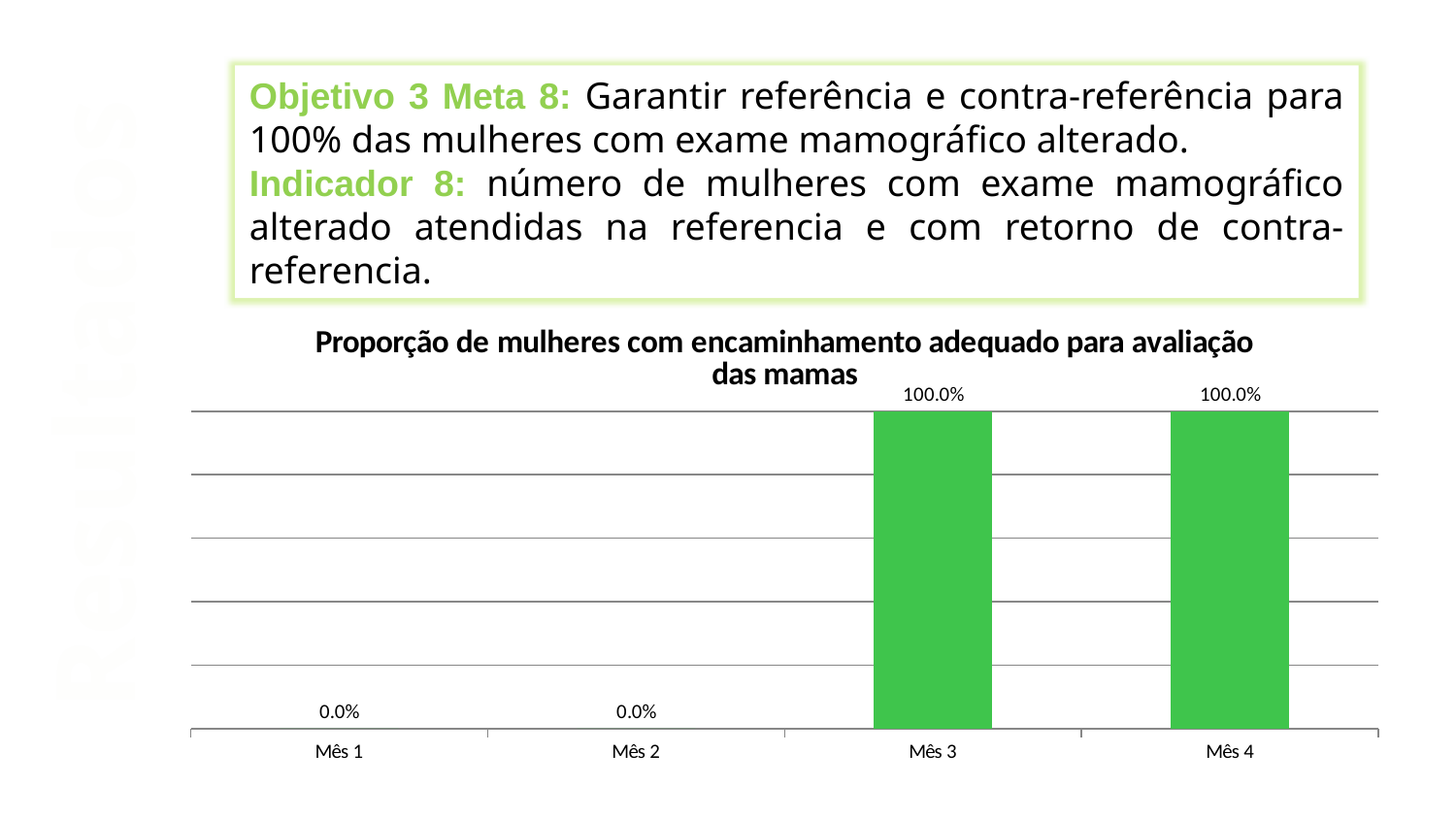
Which months share the highest value in the chart? Mês 3 and Mês 4 Which months share the lowest value in the chart? Mês 1 and Mês 2 What is the value for Mês 4? 100.0% What is the value for Mês 2? 0.0% What is the value for Mês 3? 100.0% What is the value for Mês 1? 0.0% What is the difference between the values for Mês 3 and Mês 1? 100.0% What kind of chart is shown on the slide? bar chart Which is larger, the value for Mês 2 or the value for Mês 4? Mês 4 Do the values rise or fall from Mês 1 to Mês 4? rise What is the title of the chart? Proporção de mulheres com encaminhamento adequado para avaliação das mamas How many categories are shown on the x axis of the chart? 4